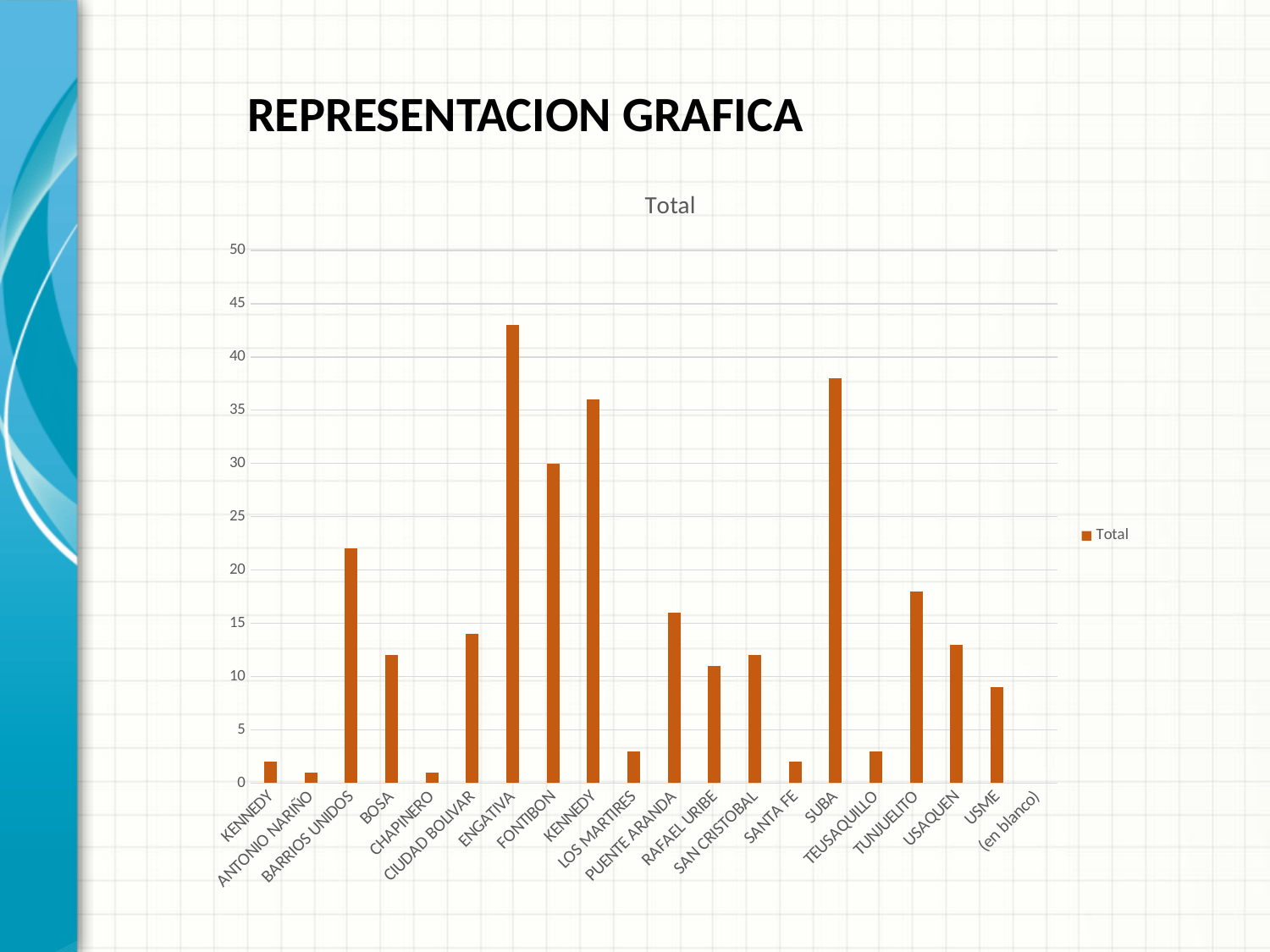
How many series does the legend list? 1 Is the value for ENGATIVA greater or less than 40? greater Is the value for TUNJUELITO greater or less than 15? greater Which category has the highest value? ENGATIVA Is the value for BARRIOS UNIDOS greater or less than 20? greater Which is larger, the value for BARRIOS UNIDOS or the value for TUNJUELITO? BARRIOS UNIDOS What kind of chart is shown on the slide? bar chart What is the title of the chart? Total Which is larger, the value for ENGATIVA or the value for SUBA? ENGATIVA How many categories are labelled on the x axis? 20